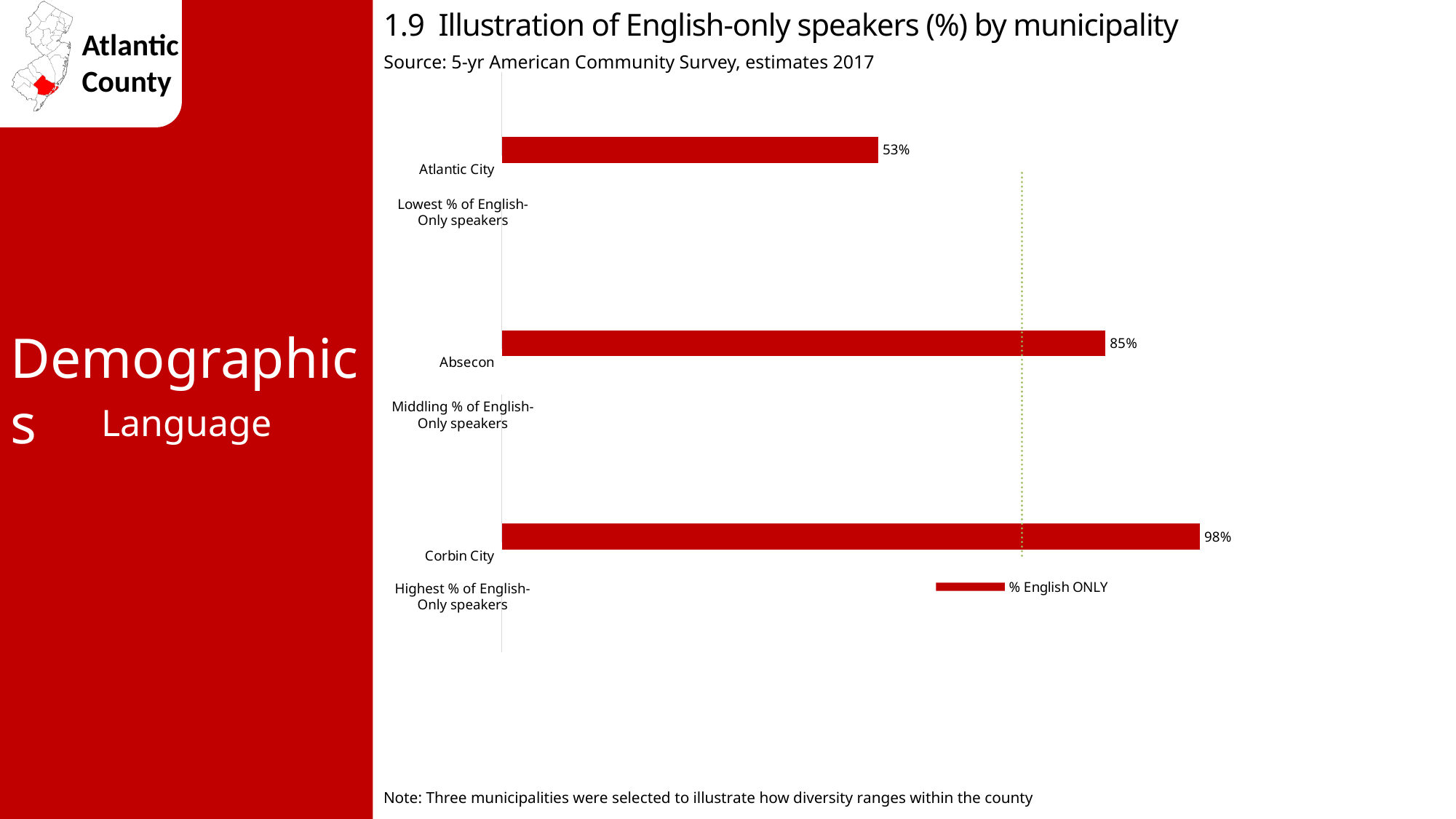
Which municipality has the lowest percentage of English-only speakers? Atlantic City What is the difference in percentage of English-only speakers between Absecon and Atlantic City? 32% What is the percentage of English-only speakers in Corbin City? 98% What is the percentage of English-only speakers in Atlantic City? 53% What is the difference in percentage of English-only speakers between Corbin City and Atlantic City? 45% Which has a higher percentage of English-only speakers, Absecon or Atlantic City? Absecon How many series does the legend list? 1 How many municipalities are shown in the chart? 3 What is the legend entry for the series shown in the chart? % English ONLY What is the percentage of English-only speakers in Absecon? 85% What kind of chart is shown on the slide? Bar chart Which municipality has the highest percentage of English-only speakers? Corbin City